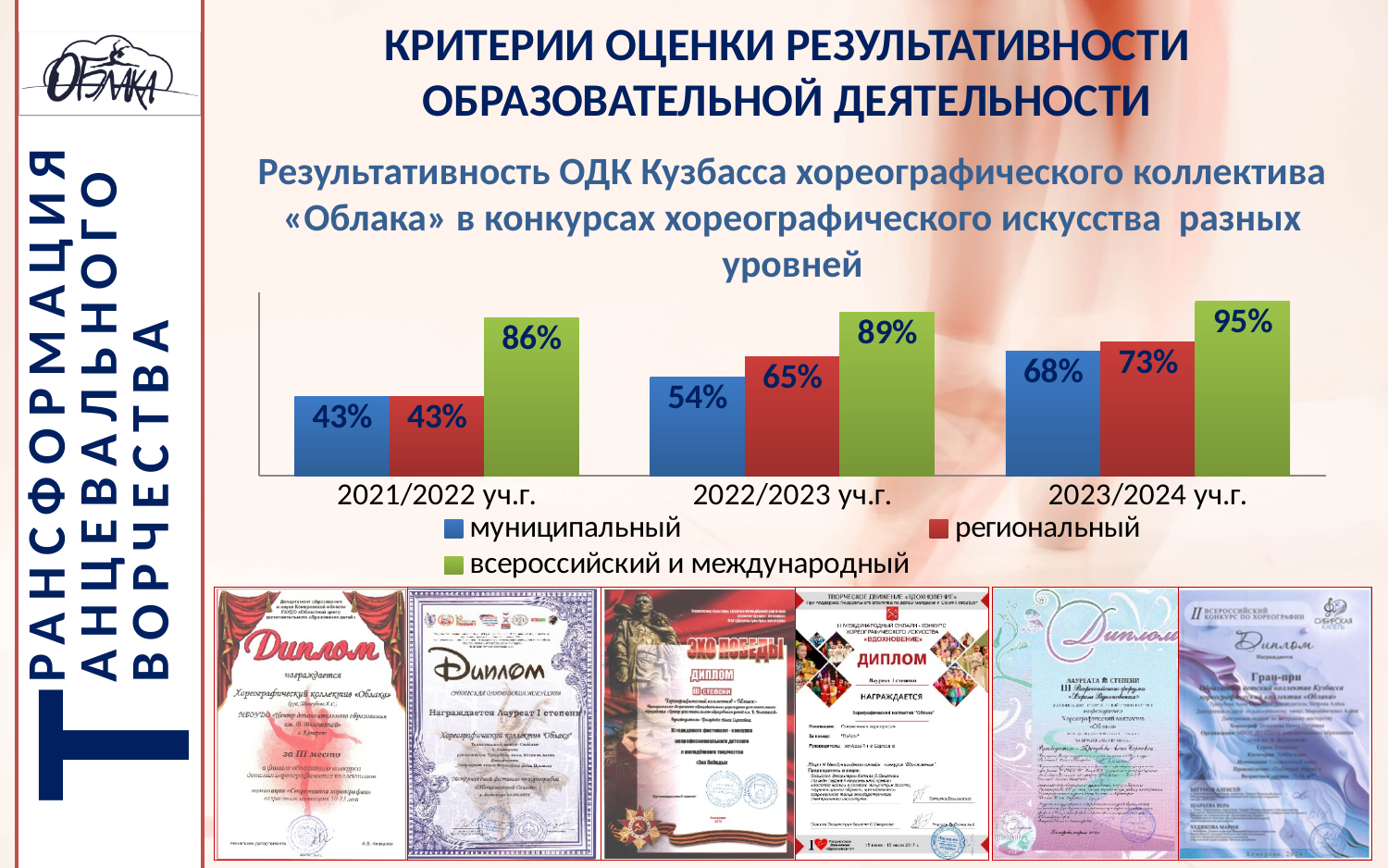
What kind of chart is shown on the slide? bar chart Which academic year has the lowest value for the всероссийский и международный series? 2021/2022 уч.г. What is the value for the муниципальный series in 2021/2022 уч.г.? 43% Which colour represents the региональный series in the chart? red What is the value for the всероссийский и международный series in 2023/2024 уч.г.? 95% Which academic year has the highest value for the муниципальный series? 2023/2024 уч.г. Which is larger in 2022/2023 уч.г.: the муниципальный value or the региональный value? региональный Do the values for the всероссийский и международный series rise or fall from 2021/2022 to 2023/2024? rise What is the difference between the региональный values in 2023/2024 уч.г. and 2021/2022 уч.г.? 30% What is the value for the региональный series in 2022/2023 уч.г.? 65% How many series does the chart legend list? 3 How many academic years are shown on the x axis of the chart? 3